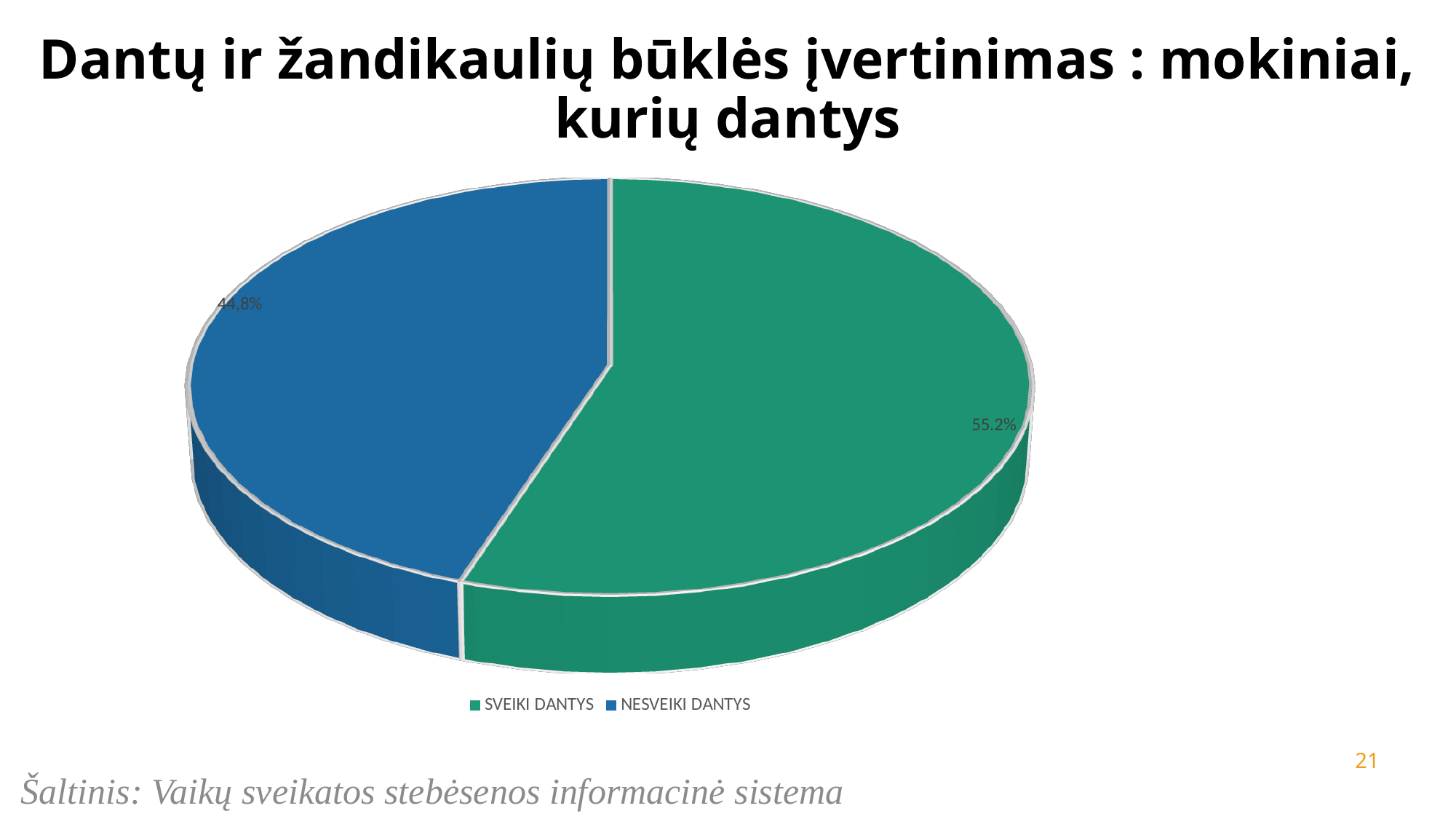
What percentage of the pie is labelled for NESVEIKI DANTYS? 44,8% What percentage of the pie is labelled for SVEIKI DANTYS? 55.2% What share of the pie does the NESVEIKI DANTYS slice take? 44,8% Which is larger, the share for SVEIKI DANTYS or the share for NESVEIKI DANTYS? SVEIKI DANTYS Which slice of the pie is the largest? SVEIKI DANTYS What colour is the SVEIKI DANTYS slice? green What colour is the NESVEIKI DANTYS slice? blue What is the difference in percentage points between the SVEIKI DANTYS slice and the NESVEIKI DANTYS slice? 10,4 Which slice of the pie is the smallest? NESVEIKI DANTYS What kind of chart is shown on the slide? pie chart How many slices does the pie chart have? 2 How many entries does the legend list? 2